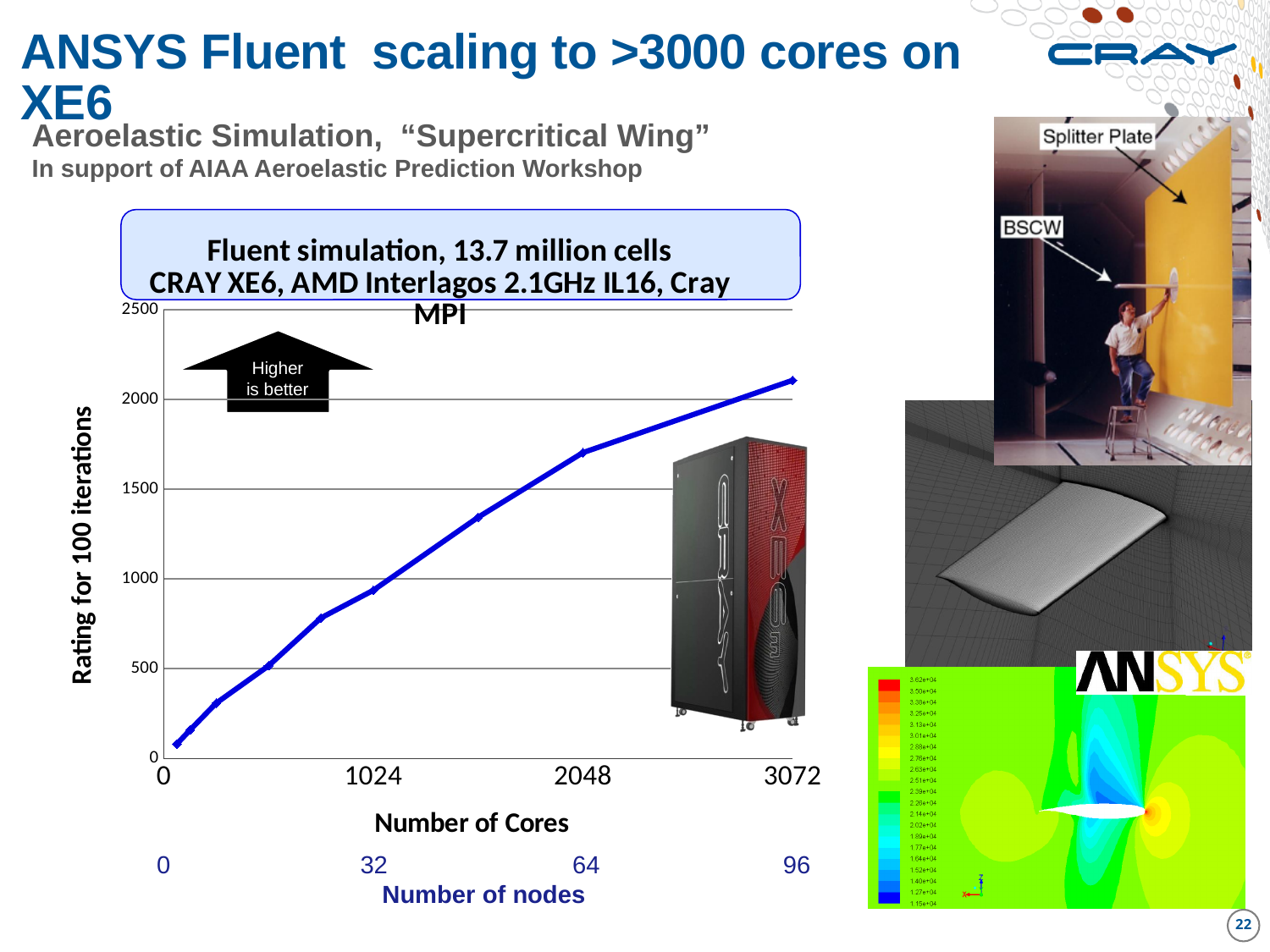
How many data points are plotted on the line? 9 Which has the higher rating, 1024 cores or 2048 cores? 2048 cores Is the rating at 2048 cores greater or less than 2000? less Is the rating at 2048 cores greater or less than 1500? greater What is the label of the y-axis of the chart? Rating for 100 iterations What is the highest value shown on the y-axis? 2500 Is the rating at 3072 cores greater or less than 2000? greater Does the rating rise or fall as the number of cores increases? rises What kind of chart is shown on the slide? line chart Which number of cores gives the highest rating for 100 iterations? 3072 What is the title of the chart? Fluent simulation, 13.7 million cells CRAY XE6, AMD Interlagos 2.1GHz IL16, Cray MPI